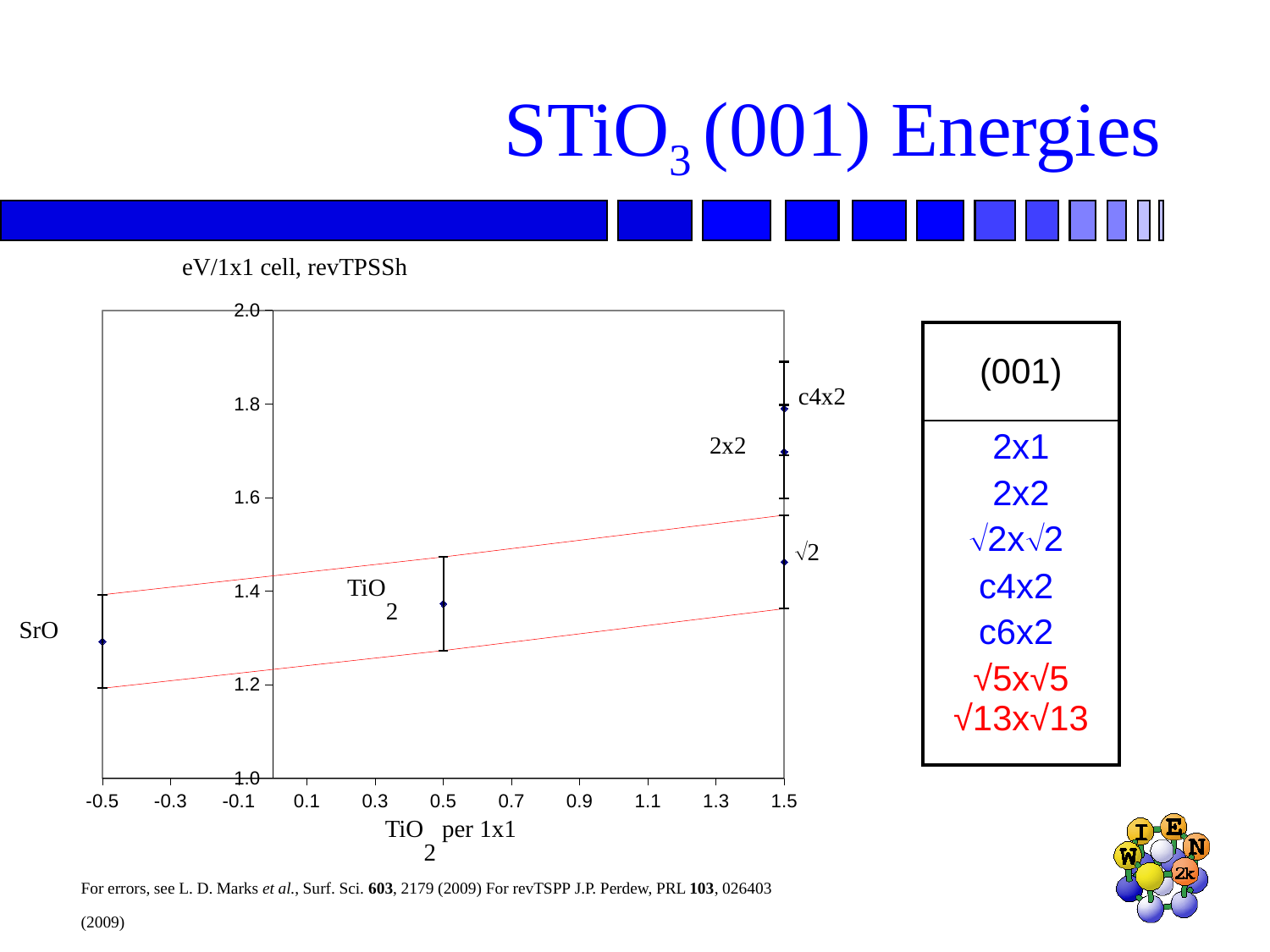
Is the value for TiO2 greater or less than 1.2? greater What is the unit label shown above the y axis of the chart? eV/1x1 cell, revTPSSh Which has the larger energy value, c4x2 or 2x2? c4x2 Is the value for c4x2 greater or less than 1.6? greater Is the value for √2 greater or less than 1.6? less Which has the larger energy value, √2 or SrO? √2 What kind of chart is shown on the slide? scatter chart At what value of TiO2 per 1x1 is the SrO point plotted? -0.5 Which labeled point has the lowest energy value? SrO How many labeled data points are plotted on the chart? 5 Which labeled point has the highest energy value? c4x2